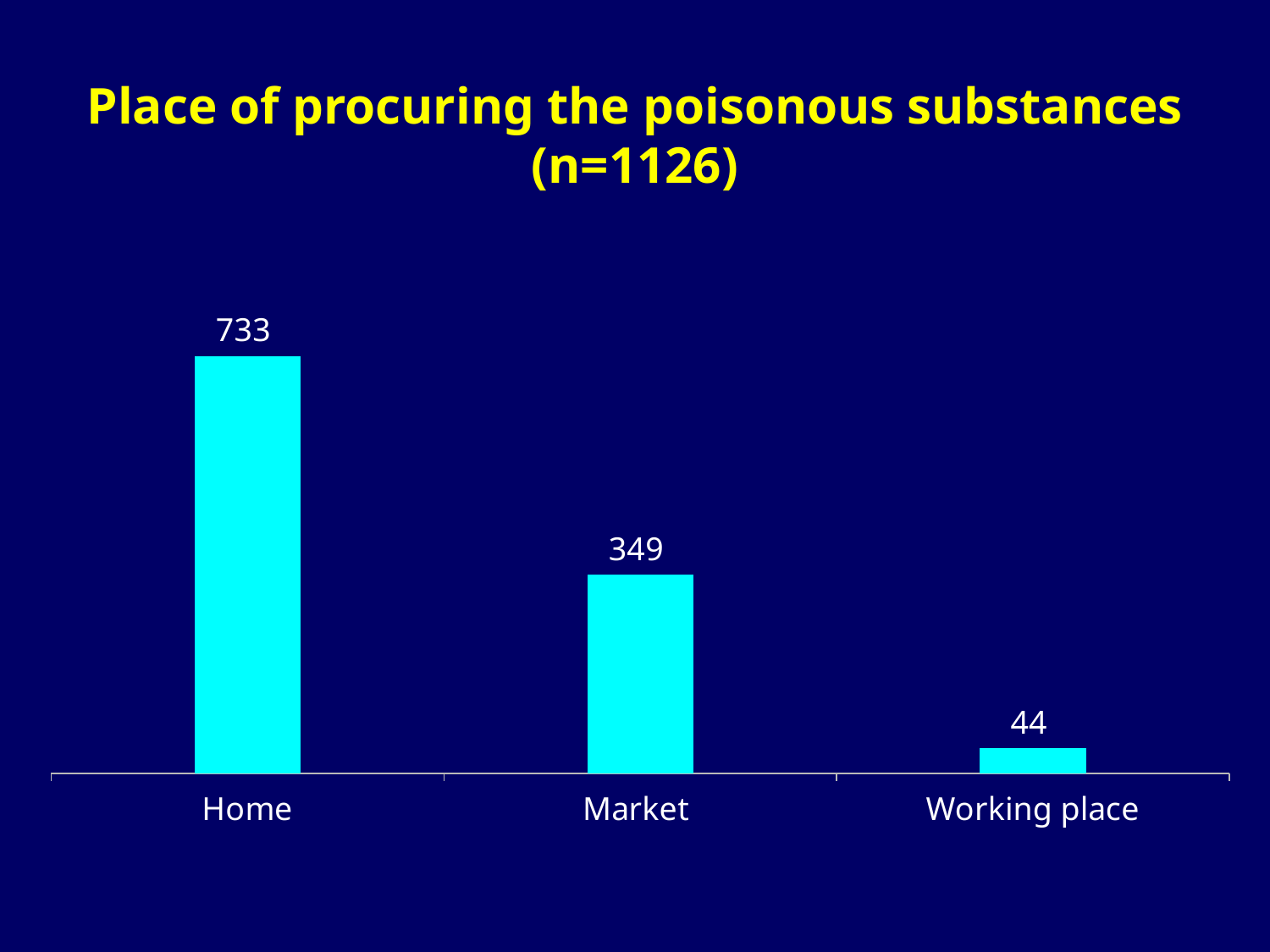
Which place has the highest value? Home What is the difference between the values for Market and Working place? 305 What kind of chart is shown on the slide? Bar chart What is the difference between the values for Home and Market? 384 Do the values rise or fall from left to right along the x axis? Fall What is the title of the chart? Place of procuring the poisonous substances (n=1126) What is the value for Market? 349 Which is larger, the value for Market or the value for Working place? Market What is the value for Working place? 44 How many categories are shown on the x axis? 3 What is the value for Home? 733 Which place has the lowest value? Working place